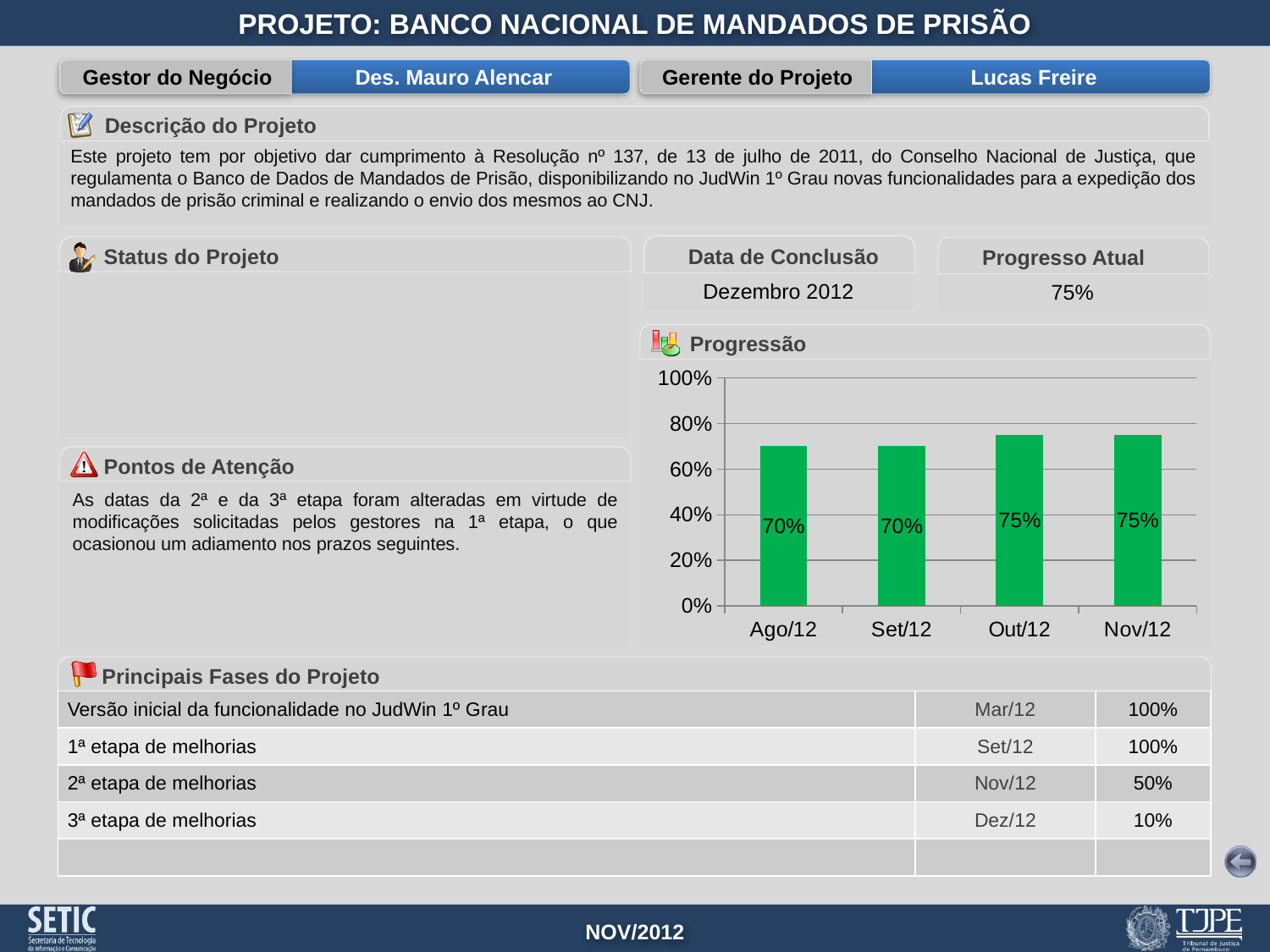
What is the title of the chart on the slide? Progressão What kind of chart is the Progressão chart? bar chart What is the difference between the values for Out/12 and Ago/12 in the Progressão chart? 5% How many categories are shown on the x axis of the Progressão chart? 4 Do the values in the Progressão chart rise or fall from Ago/12 to Nov/12? rise What is the value for Ago/12 in the Progressão chart? 70% Is the value for Ago/12 in the Progressão chart greater or less than 80%? less What is the value for Out/12 in the Progressão chart? 75% What is the value for Set/12 in the Progressão chart? 70% Which is larger in the Progressão chart, the value for Set/12 or the value for Nov/12? Nov/12 What is the value for Nov/12 in the Progressão chart? 75% What colour are the bars in the Progressão chart? green